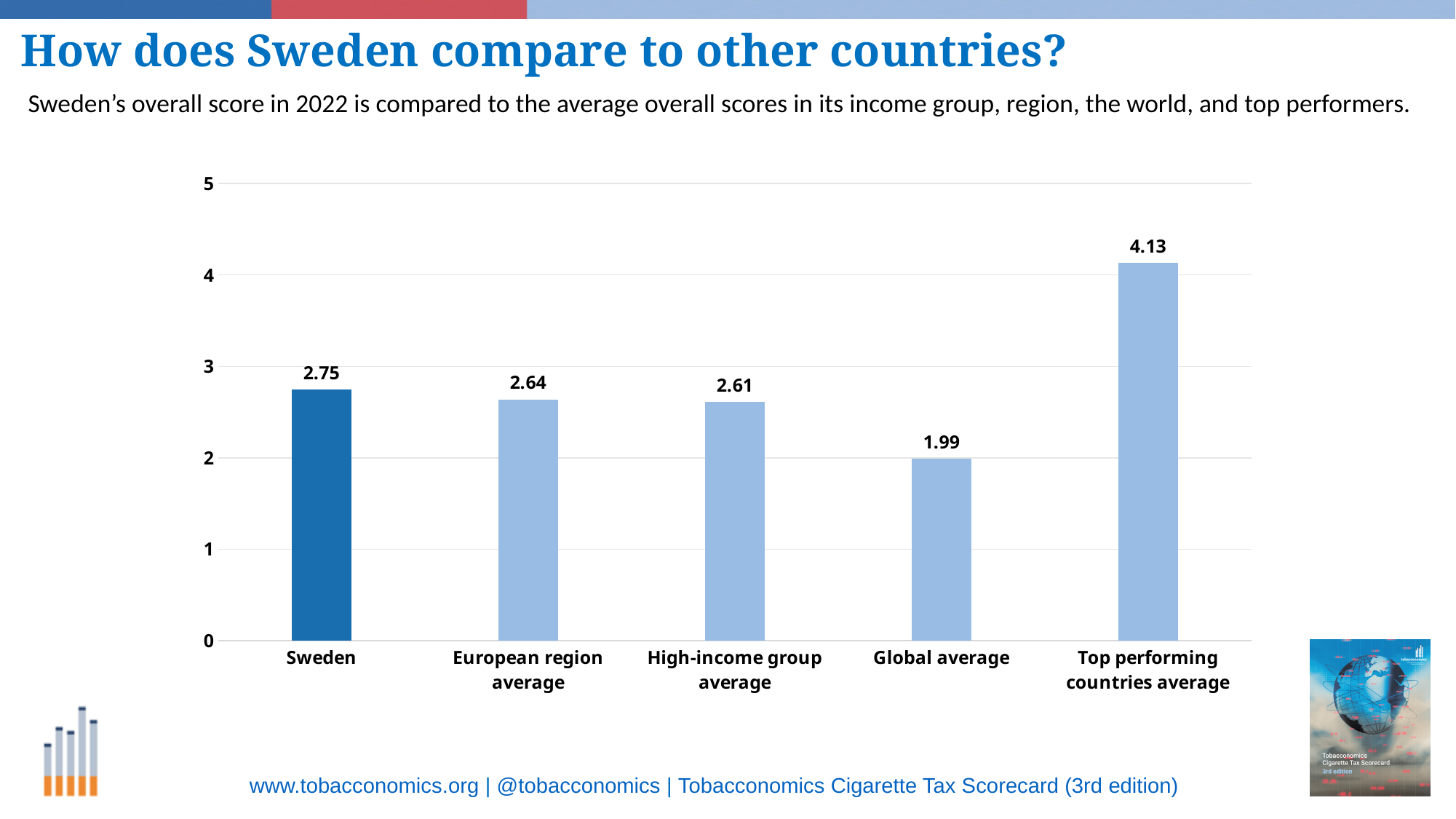
What is the value shown for the Global average? 1.99 Which bar is shown in a darker blue than the others? Sweden What is the difference between the Top performing countries average and Sweden's score? 1.38 What is the overall score shown for Sweden? 2.75 What is the value shown for the Top performing countries average? 4.13 Which category has the lowest value? Global average How many categories are shown on the chart? 5 Which is larger, Sweden's score or the European region average? Sweden What is the difference between Sweden's score and the Global average? 0.76 What kind of chart is shown on the slide? Bar chart Which category has the highest value? Top performing countries average What is the value shown for the High-income group average? 2.61